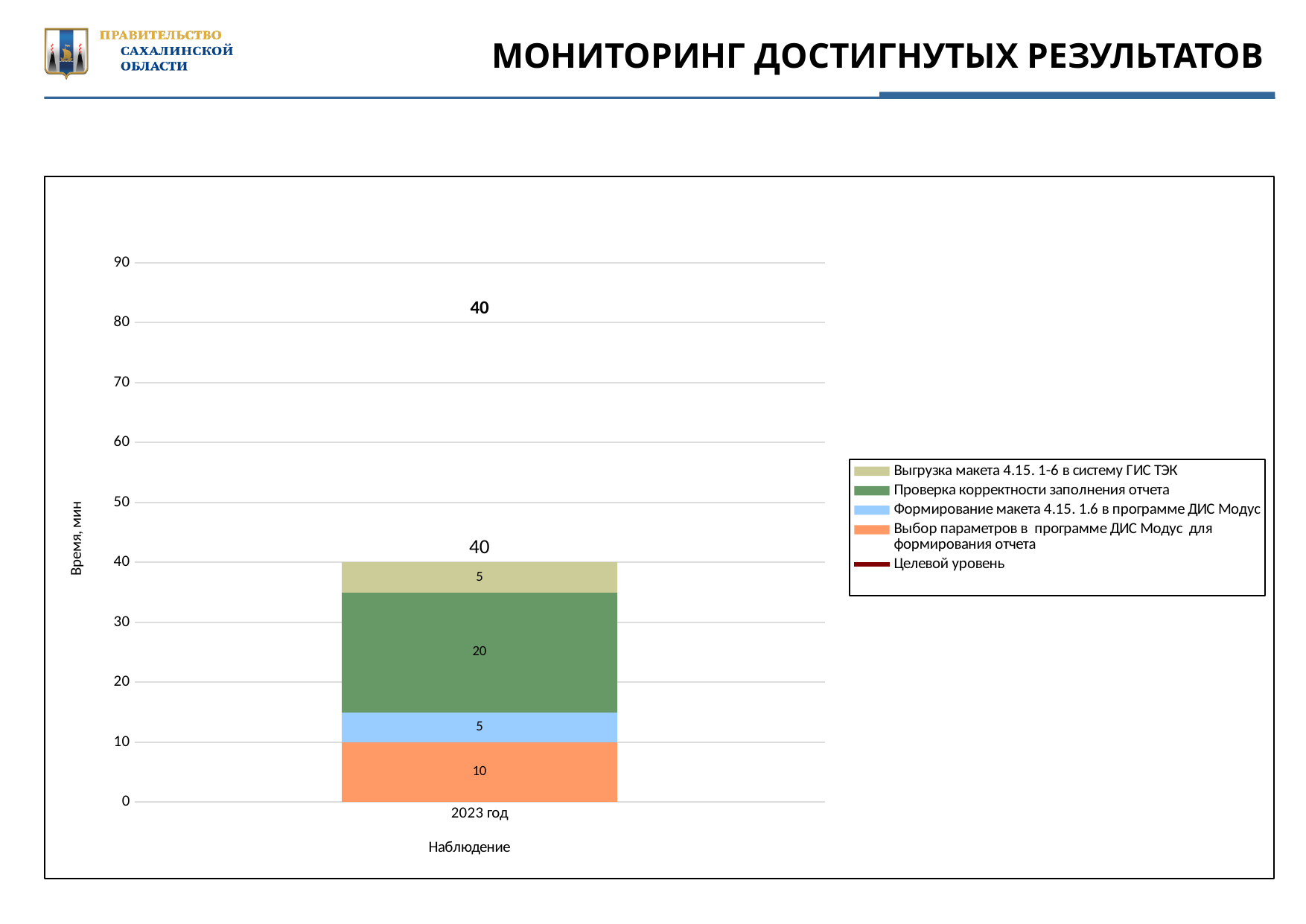
What is the value of the segment 'Формирование макета 4.15. 1.6 в программе ДИС Модус' for 2023 год? 5 What is the label of the vertical axis of the chart? Время, мин How many categories are shown on the x axis of the chart? 1 Which is larger for 2023 год: the 'Выбор параметров в программе ДИС Модус для формирования отчета' segment or the 'Выгрузка макета 4.15. 1-6 в систему ГИС ТЭК' segment? Выбор параметров в программе ДИС Модус для формирования отчета What is the value of the segment 'Проверка корректности заполнения отчета' for 2023 год? 20 How many entries does the chart legend list? 5 What kind of chart is shown on the slide? Stacked bar chart What is the difference between the 'Проверка корректности заполнения отчета' segment and the 'Выбор параметров в программе ДИС Модус для формирования отчета' segment for 2023 год? 10 Which segment of the 2023 год bar has the largest value? Проверка корректности заполнения отчета What is the total of the stacked bar for 2023 год? 40 What is the value of the segment 'Выбор параметров в программе ДИС Модус для формирования отчета' for 2023 год? 10 What is the value of the segment 'Выгрузка макета 4.15. 1-6 в систему ГИС ТЭК' for 2023 год? 5